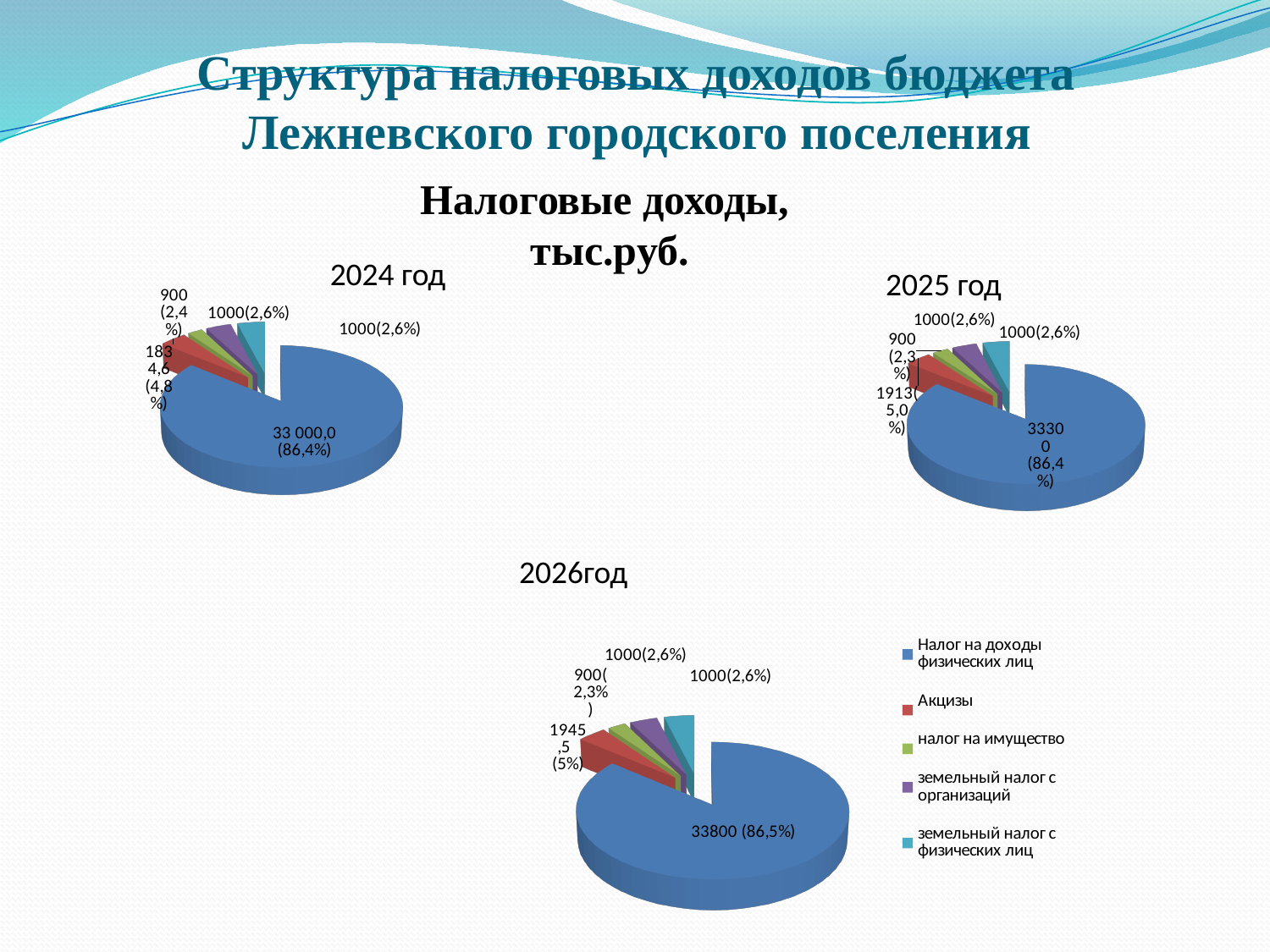
In the 2026 год chart, what is the value shown for Налог на доходы физических лиц? 33800 (86,5%) In the 2024 год chart, which category has the smallest value? налог на имущество How many series does the legend list? 5 What type of chart is used on this slide for the 2024 год, 2025 год and 2026 год data? Pie chart In the 2024 год chart, what is the value shown for the largest slice (Налог на доходы физических лиц)? 33 000,0 (86,4%) In the 2025 год chart, what is the value shown for Акцизы? 1913 (5,0%) In the 2026 год chart, what is the difference between the Акцизы value and the налог на имущество value? 1045,5 In the 2025 год chart, what share of the pie does the Налог на доходы физических лиц slice have? 86,4% In the 2024 год chart, which is larger: Акцизы or налог на имущество? Акцизы In the 2026 год chart, what is the value shown for Акцизы? 1945,5 (5%) How many slices does the 2025 год pie chart have? 5 In the 2026 год chart, which category has the largest value? Налог на доходы физических лиц